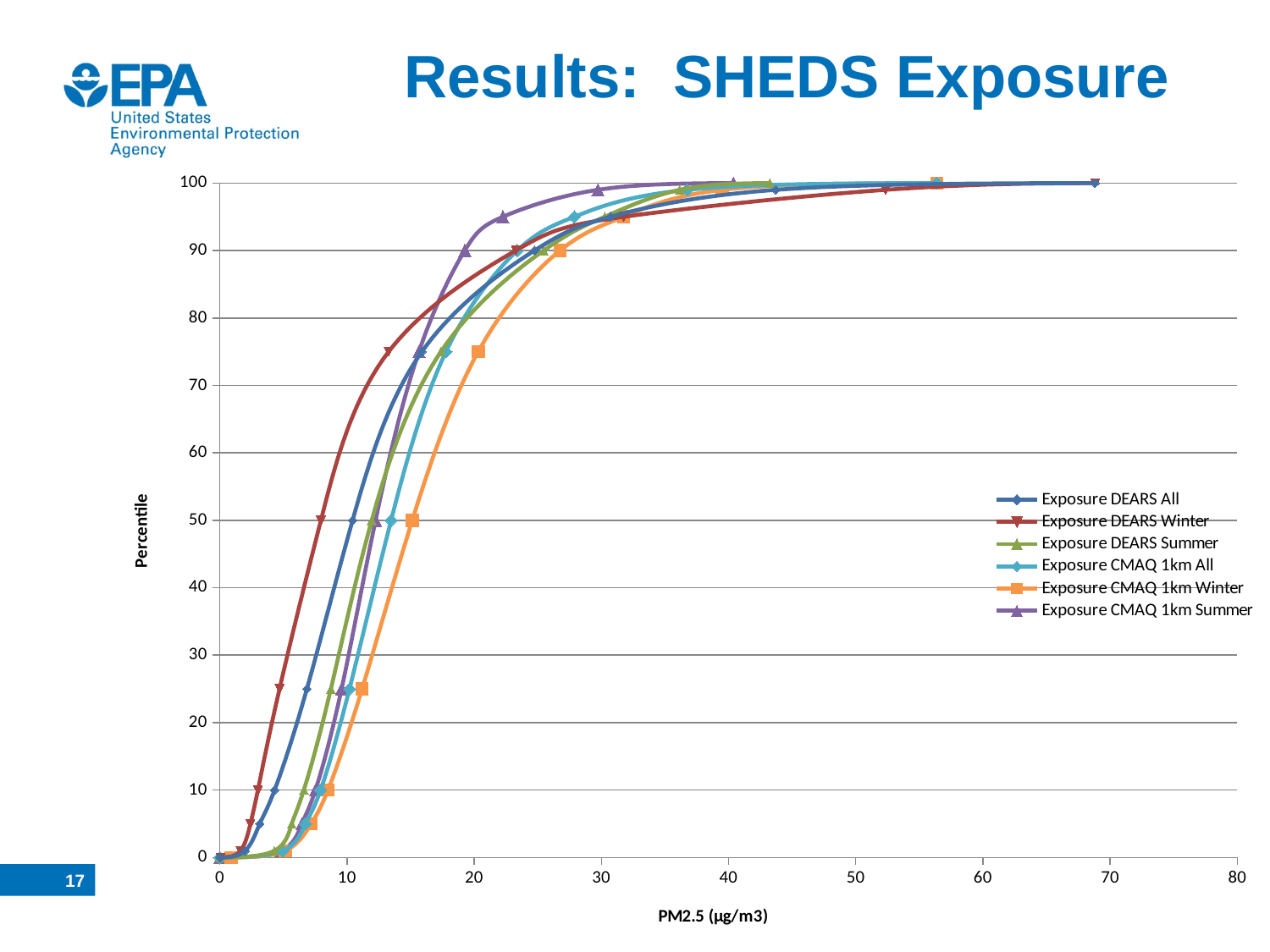
What kind of chart is shown on the slide? line chart Is the PM2.5 value at which Exposure CMAQ 1km Winter reaches the 50th percentile greater or less than 10? greater Do the percentile values rise or fall as PM2.5 increases along the x axis? rise Which series reaches the 50th percentile at the highest PM2.5 value? Exposure CMAQ 1km Winter What is the label of the x axis? PM2.5 (µg/m3) Is the PM2.5 value at which Exposure CMAQ 1km Summer reaches the 90th percentile greater or less than 30? less At the 50th percentile, which series has the larger PM2.5 value: Exposure DEARS Winter or Exposure CMAQ 1km Winter? Exposure CMAQ 1km Winter How many series does the legend list? 6 Is the PM2.5 value at which Exposure DEARS Winter reaches the 50th percentile greater or less than 10? less At the 25th percentile, which series has the larger PM2.5 value: Exposure DEARS All or Exposure CMAQ 1km Winter? Exposure CMAQ 1km Winter Which series reaches the 50th percentile at the lowest PM2.5 value? Exposure DEARS Winter What is the label of the y axis? Percentile